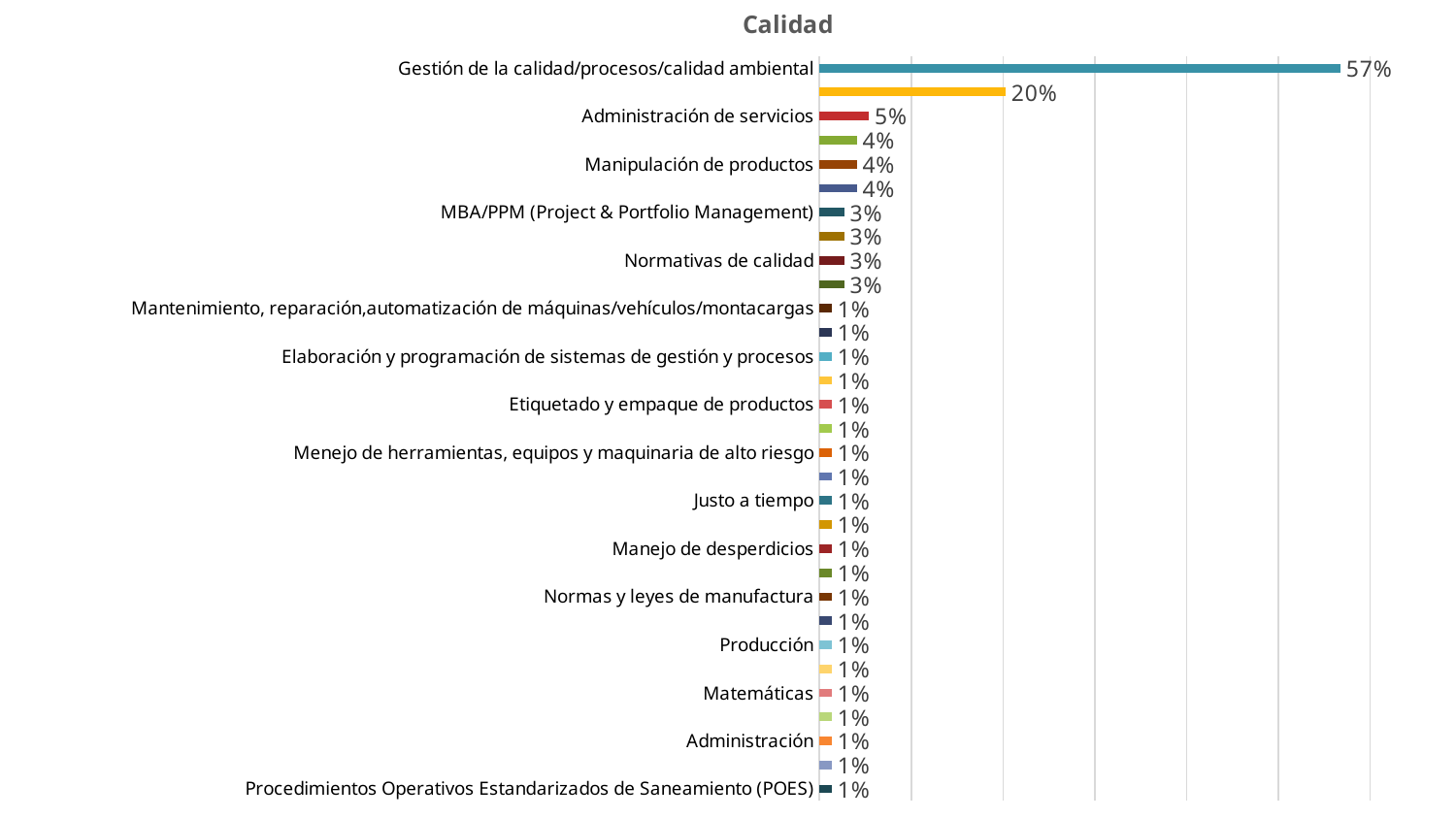
What is the value for MBA/PPM (Project & Portfolio Management)? 3% What is the difference between the values for Gestión de la calidad/procesos/calidad ambiental and Administración de servicios? 52 percentage points What is the value for Gestión de la calidad/procesos/calidad ambiental? 57% What is the value for Manipulación de productos? 4% What is the value for Justo a tiempo? 1% Which is larger, the value for Administración de servicios or the value for Manipulación de productos? Administración de servicios What is the value for Administración de servicios? 5% What is the value for Normativas de calidad? 3% How many bars are plotted in the chart? 31 What kind of chart is shown on the slide? bar chart Which category has the highest value? Gestión de la calidad/procesos/calidad ambiental What is the title of the chart? Calidad